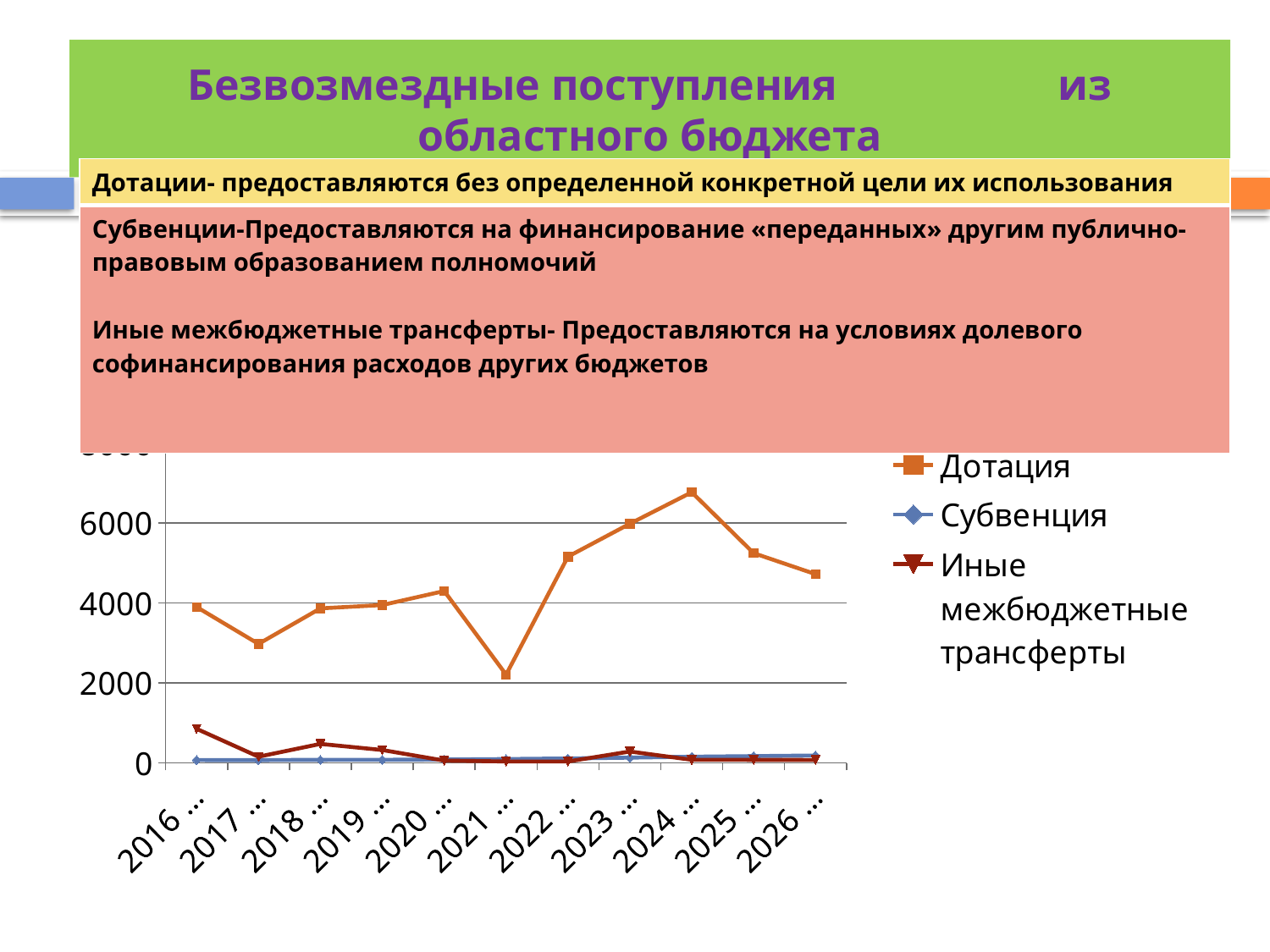
Which series has the larger value in 2016: Дотация or Субвенция? Дотация Does the Дотация series rise or fall from 2024 to 2026? fall What kind of chart is shown on the slide? line chart In which year does the Дотация series reach its lowest value? 2021 How many series does the legend list? 3 Which series is drawn in orange with square markers? Дотация Is the value for Дотация in 2021 greater or less than 4000? less Is the value for Дотация in 2017 greater or less than 4000? less How many points (years) are plotted along the x axis? 11 Is the value for Иные межбюджетные трансферты in 2016 greater or less than 2000? less In which year does the Дотация series reach its highest value? 2024